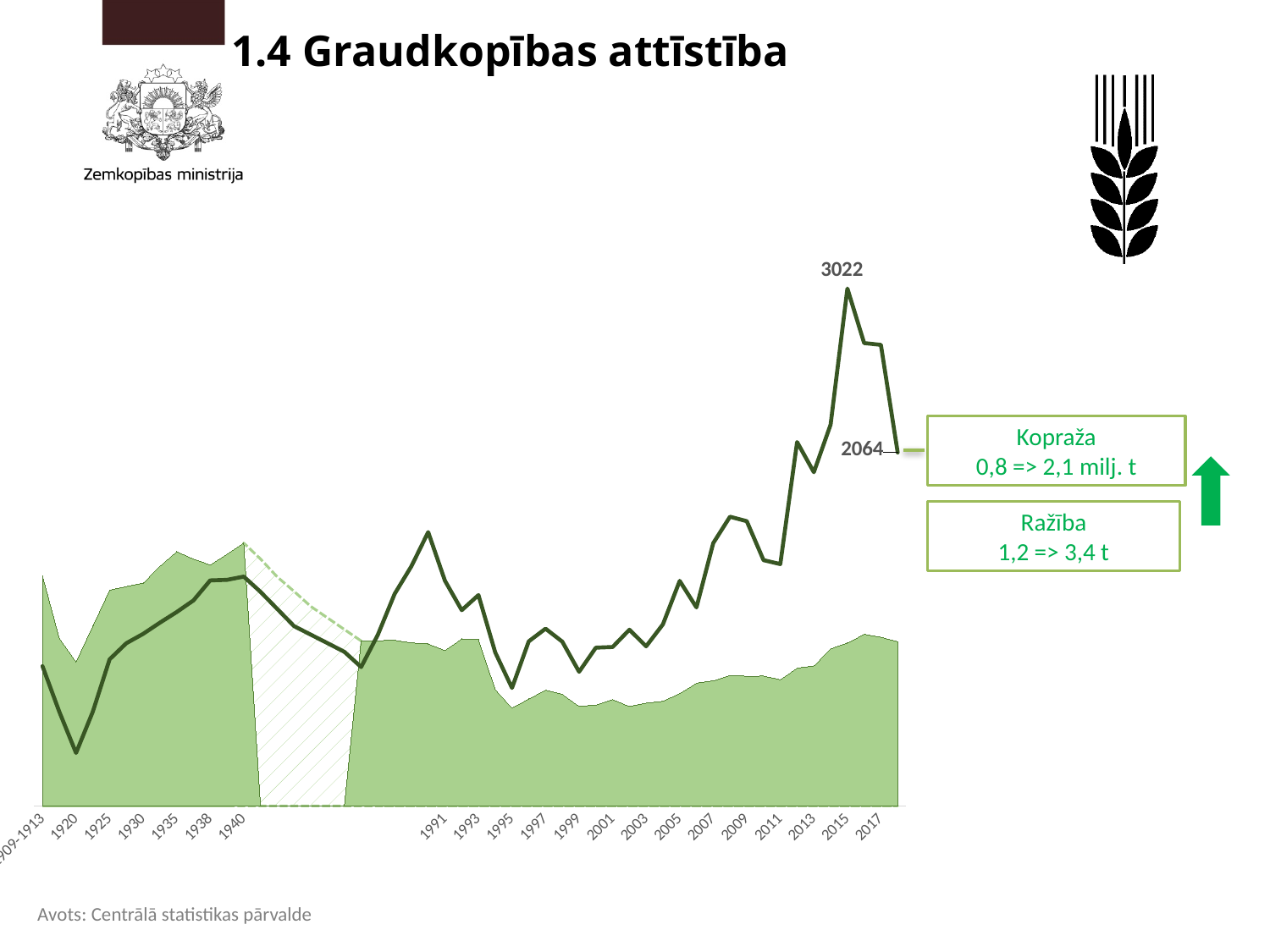
Does the dark green line rise or fall overall between 2009 and 2015? rise What is the title of the slide containing the chart? 1.4 Graudkopības attīstība What source is cited below the chart? Centrālā statistikas pārvalde Does the dark green line rise or fall between 1991 and 1995? fall What is the first label on the x axis? 1909-1913 What is the difference between the two labelled values on the line, 3022 and 2064? 958 What value is labelled at the right-hand end of the dark green line? 2064 How many year labels are shown on the x axis? 21 Which labelled value on the line is larger, the peak value or the final value? 3022 Does the dark green line rise or fall between 1920 and 1938? rise What is the highest value labelled on the dark green line? 3022